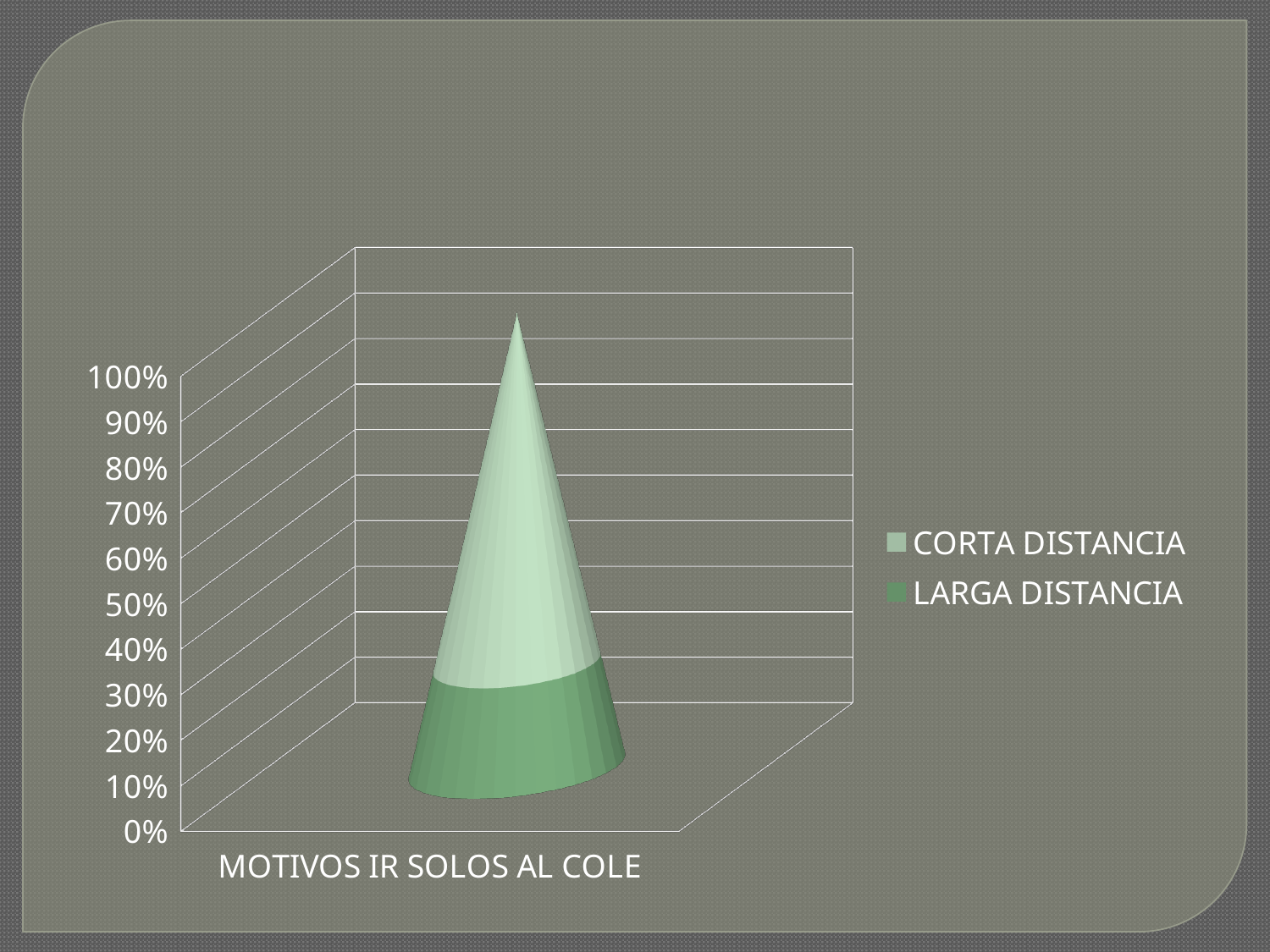
Which series has the largest segment in the stacked bar? CORTA DISTANCIA What is the highest value shown on the vertical axis? 100% What is the category label shown on the x axis? MOTIVOS IR SOLOS AL COLE How many series does the legend list? 2 What are the two series named in the legend? CORTA DISTANCIA and LARGA DISTANCIA Which series has the smallest segment in the stacked bar? LARGA DISTANCIA How many categories are shown on the x axis? 1 Is the share for LARGA DISTANCIA greater or less than 50%? less What kind of chart is shown on the slide? Stacked bar chart Is the share for CORTA DISTANCIA greater or less than 50%? greater Which series takes up the larger share of the stacked bar, CORTA DISTANCIA or LARGA DISTANCIA? CORTA DISTANCIA